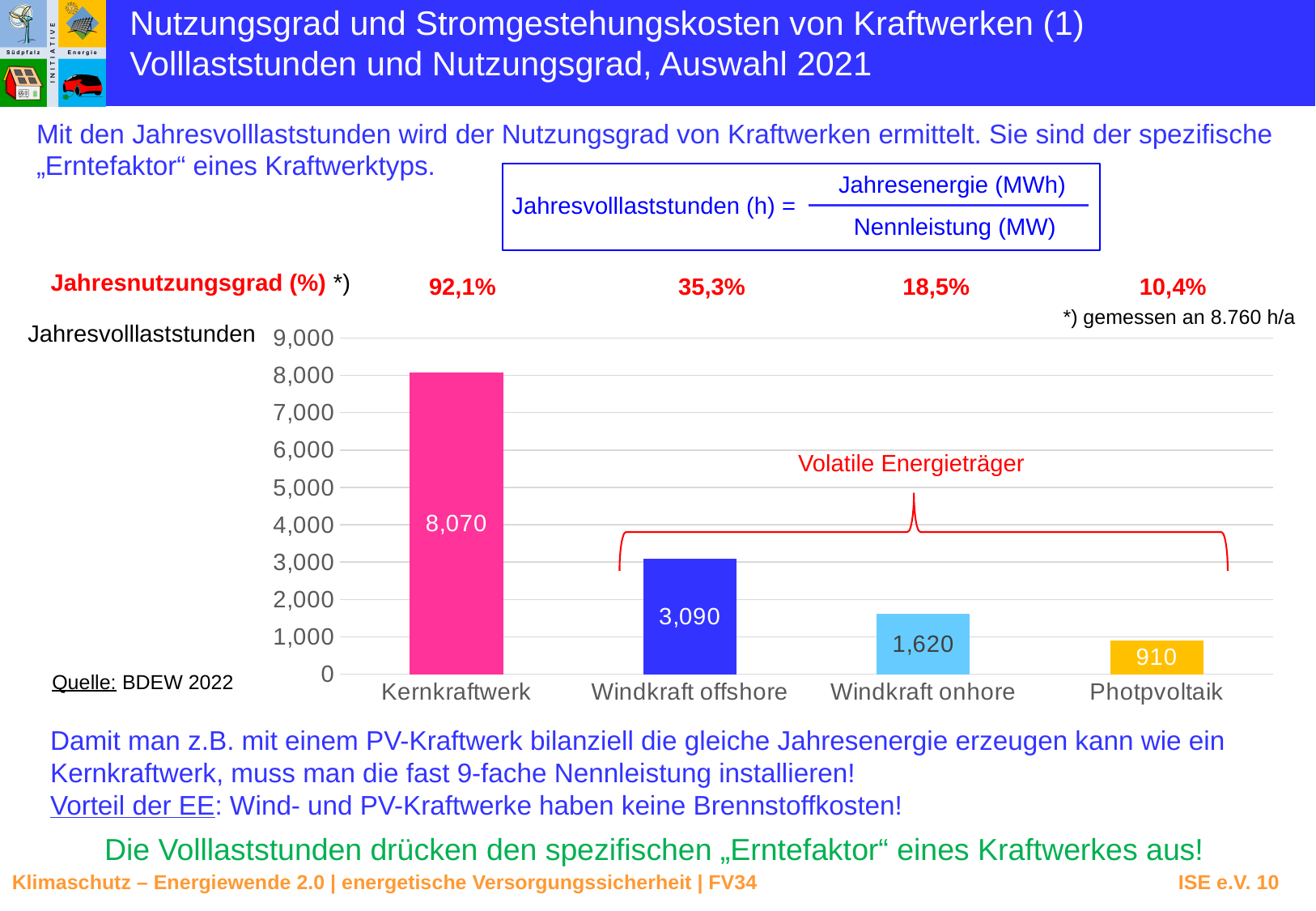
How many categories are shown in the Jahresvolllaststunden chart? 4 What is the difference in Jahresvolllaststunden between Windkraft onhore and Photpvoltaik? 710 What is the difference in Jahresvolllaststunden between Kernkraftwerk and Windkraft offshore? 4,980 What kind of chart is used to show the Jahresvolllaststunden? Bar chart Which has more Jahresvolllaststunden, Windkraft offshore or Windkraft onhore? Windkraft offshore What is the value for Windkraft offshore in the Jahresvolllaststunden chart? 3,090 What is the value for Windkraft onhore in the Jahresvolllaststunden chart? 1,620 Which category has the highest Jahresvolllaststunden? Kernkraftwerk Which category has the lowest Jahresvolllaststunden? Photpvoltaik What is the value for Kernkraftwerk in the Jahresvolllaststunden chart? 8,070 What is the value for Photpvoltaik in the Jahresvolllaststunden chart? 910 Do the values rise or fall from left to right across the categories in the chart? Fall